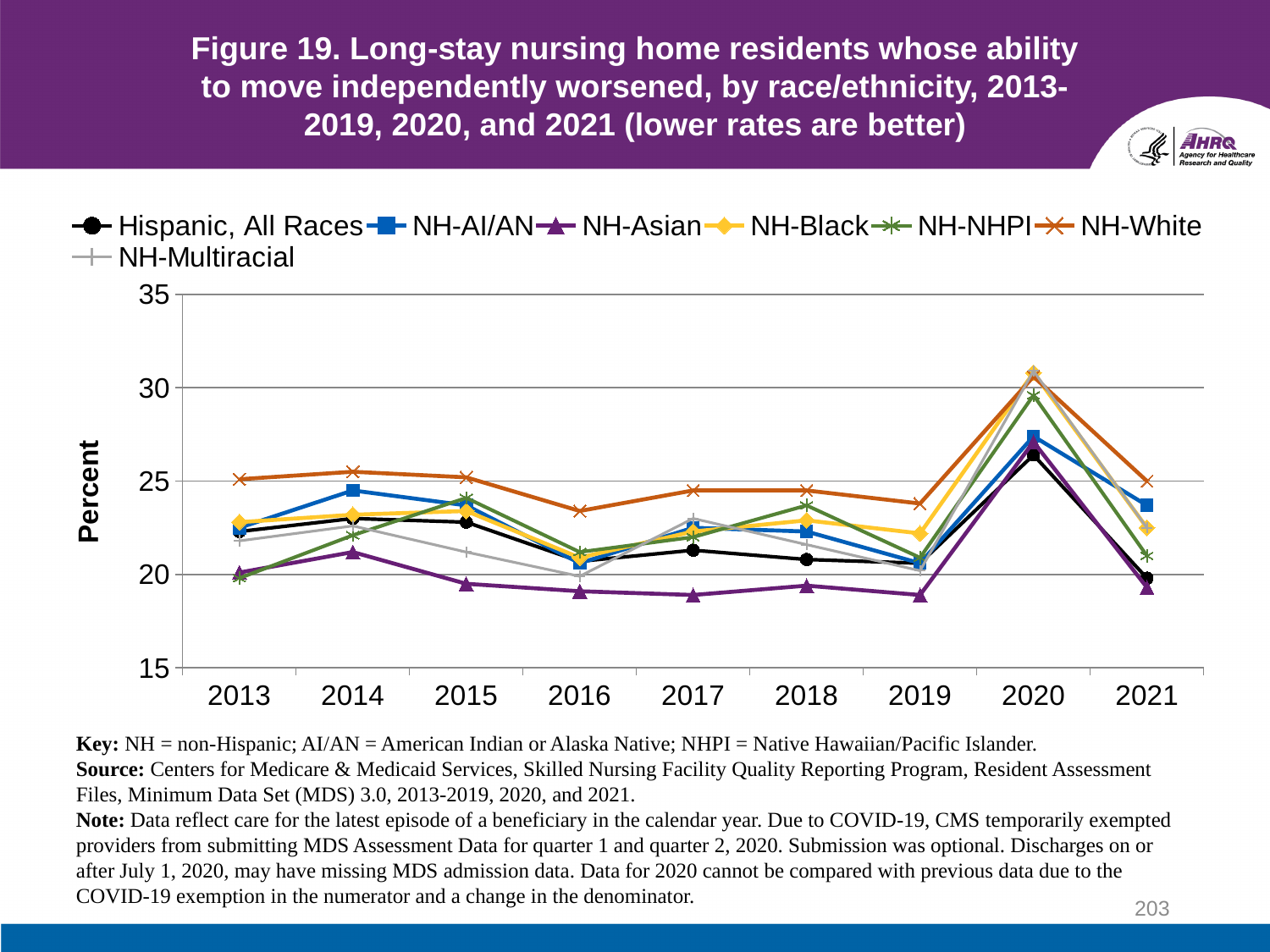
How many series does the legend list? 7 Is the value for Hispanic, All Races in 2020 greater or less than 25? greater How many years are shown along the x axis? 9 Is the value for NH-Asian in 2017 greater or less than 20? less What is the label on the y axis? Percent Is the value for NH-White in 2016 greater or less than 25? less Which race/ethnicity group had the highest rate in 2013? NH-White Which race/ethnicity group had the lowest rate in 2017? NH-Asian Did the value for NH-Asian rise or fall from 2020 to 2021? fall In 2018, which is larger, the value for NH-White or the value for NH-Asian? NH-White Did the value for NH-White rise or fall from 2019 to 2020? rise What kind of chart is shown on the slide? line chart